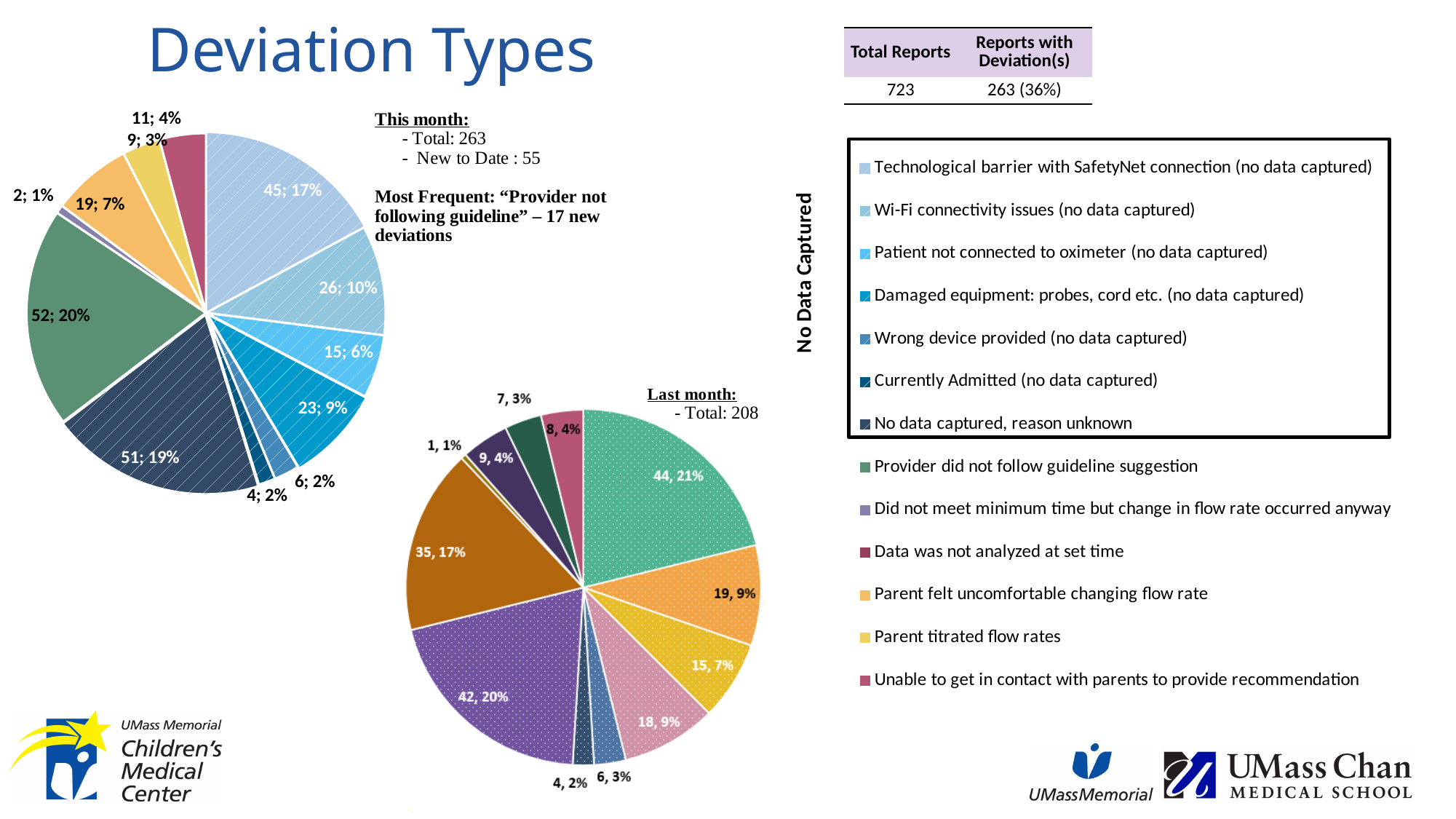
What kind of charts are shown on the slide? Pie charts In the 'This month' pie chart, what is the value for 'Technological barrier with SafetyNet connection (no data captured)'? 45; 17% In the 'This month' pie chart, what is the difference between the counts for 'Technological barrier with SafetyNet connection' and 'Wi-Fi connectivity issues'? 19 In the 'This month' pie chart, what is the value for 'Wi-Fi connectivity issues (no data captured)'? 26; 10% In the 'Last month' pie chart, what is the smallest slice's label? 1, 1% How many slices does the 'This month' pie chart have? 12 In the 'This month' pie chart, what share does 'Parent felt uncomfortable changing flow rate' have? 7% In the 'Last month' pie chart, what is the largest slice's label? 44, 21% In the 'This month' pie chart, which is larger: 'Damaged equipment: probes, cord etc.' or 'Patient not connected to oximeter'? Damaged equipment: probes, cord etc. In the 'This month' pie chart, what is the value for 'Provider did not follow guideline suggestion'? 52; 20% What is the total shown for the 'Last month' pie chart? 208 How many entries does the legend on the right of the slide list? 13